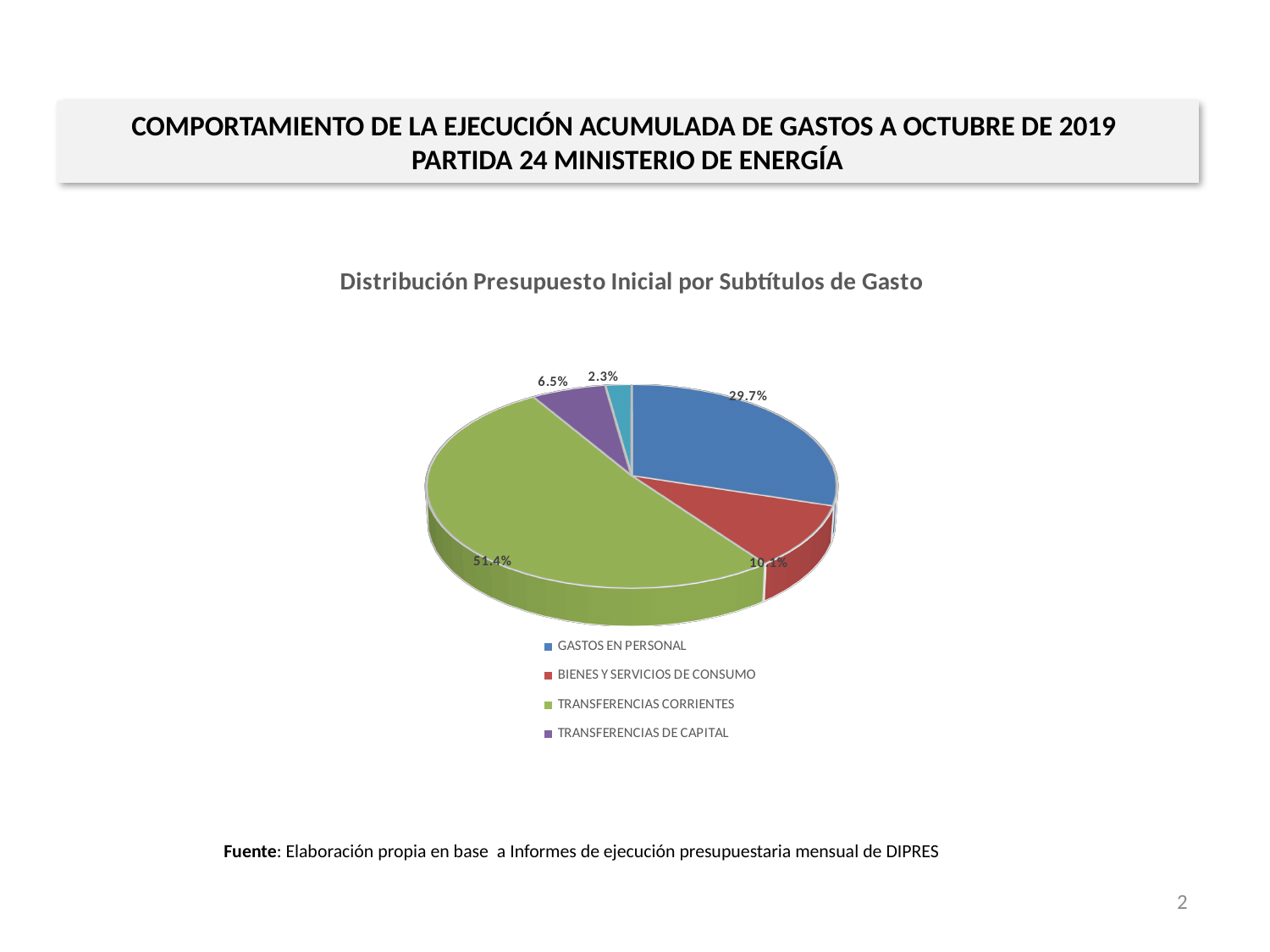
Which category has the largest slice of the pie? TRANSFERENCIAS CORRIENTES Is the share for TRANSFERENCIAS CORRIENTES greater or less than 50%? greater What share does TRANSFERENCIAS DE CAPITAL have in the pie chart? 6.5% What is the smallest percentage printed on the pie chart? 2.3% How many entries does the chart legend list? 4 Which is larger, the share for GASTOS EN PERSONAL or for BIENES Y SERVICIOS DE CONSUMO? GASTOS EN PERSONAL What is the title of the chart? Distribución Presupuesto Inicial por Subtítulos de Gasto What percentage is shown for TRANSFERENCIAS CORRIENTES? 51.4% By how many percentage points does TRANSFERENCIAS CORRIENTES exceed GASTOS EN PERSONAL? 21.7 percentage points What is the value labelled for BIENES Y SERVICIOS DE CONSUMO? 10.1% What kind of chart is shown on the slide? Pie chart What share of the pie does GASTOS EN PERSONAL represent? 29.7%